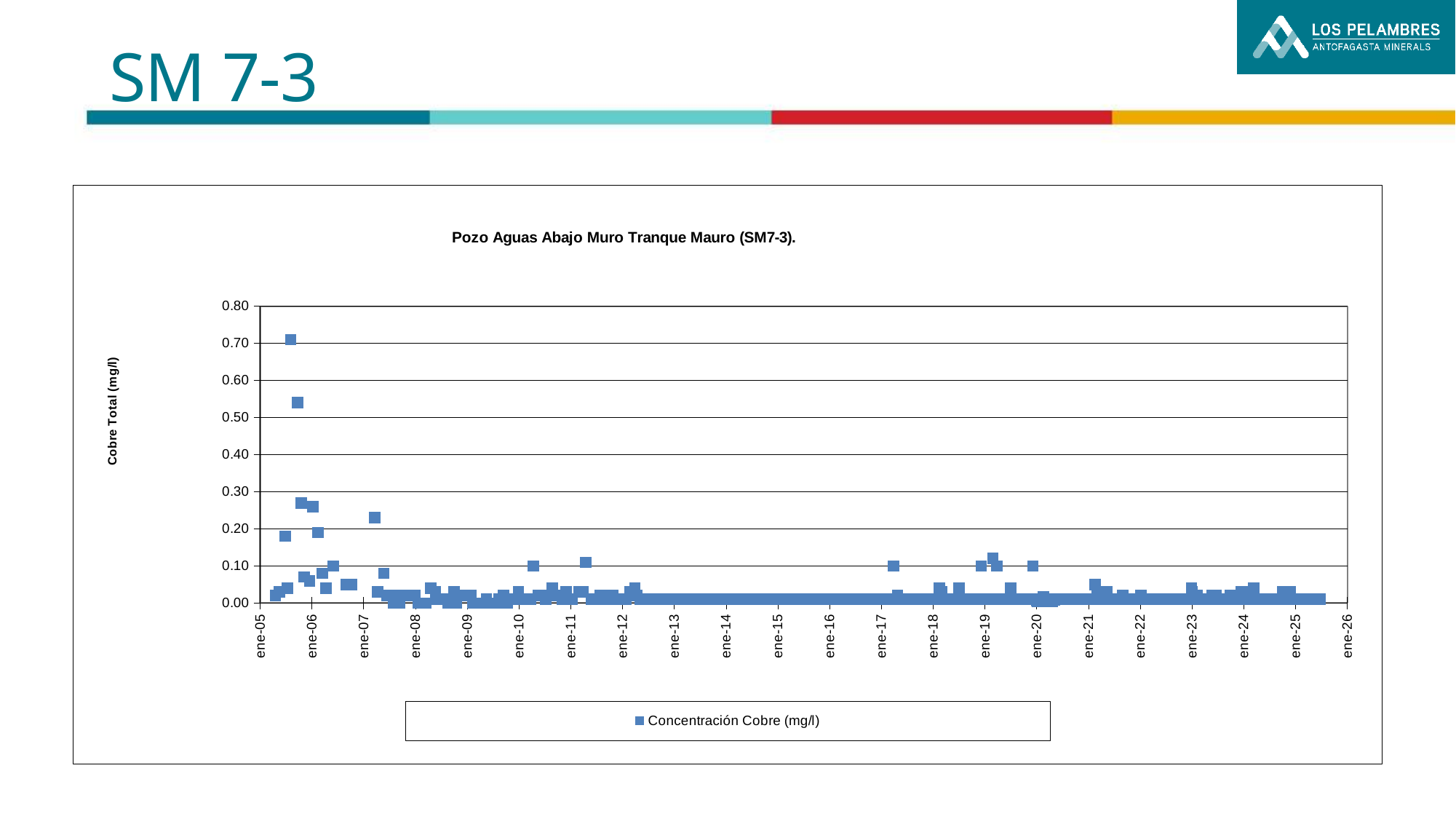
Is the highest plotted value greater or less than 0.60? greater Is the highest plotted value located before or after ene-07 on the x axis? before What kind of chart is shown on the slide? scatter chart Are the values plotted after ene-21 greater or less than 0.10? less Do the plotted values generally rise or fall along the x axis from ene-05 to ene-26? fall What is the title of the chart? Pozo Aguas Abajo Muro Tranque Mauro (SM7-3). What series name is shown in the legend? Concentración Cobre (mg/l) How many series does the legend list? 1 Is the second-highest plotted value (near ene-06) greater or less than 0.60? less How many year labels are shown on the x axis? 22